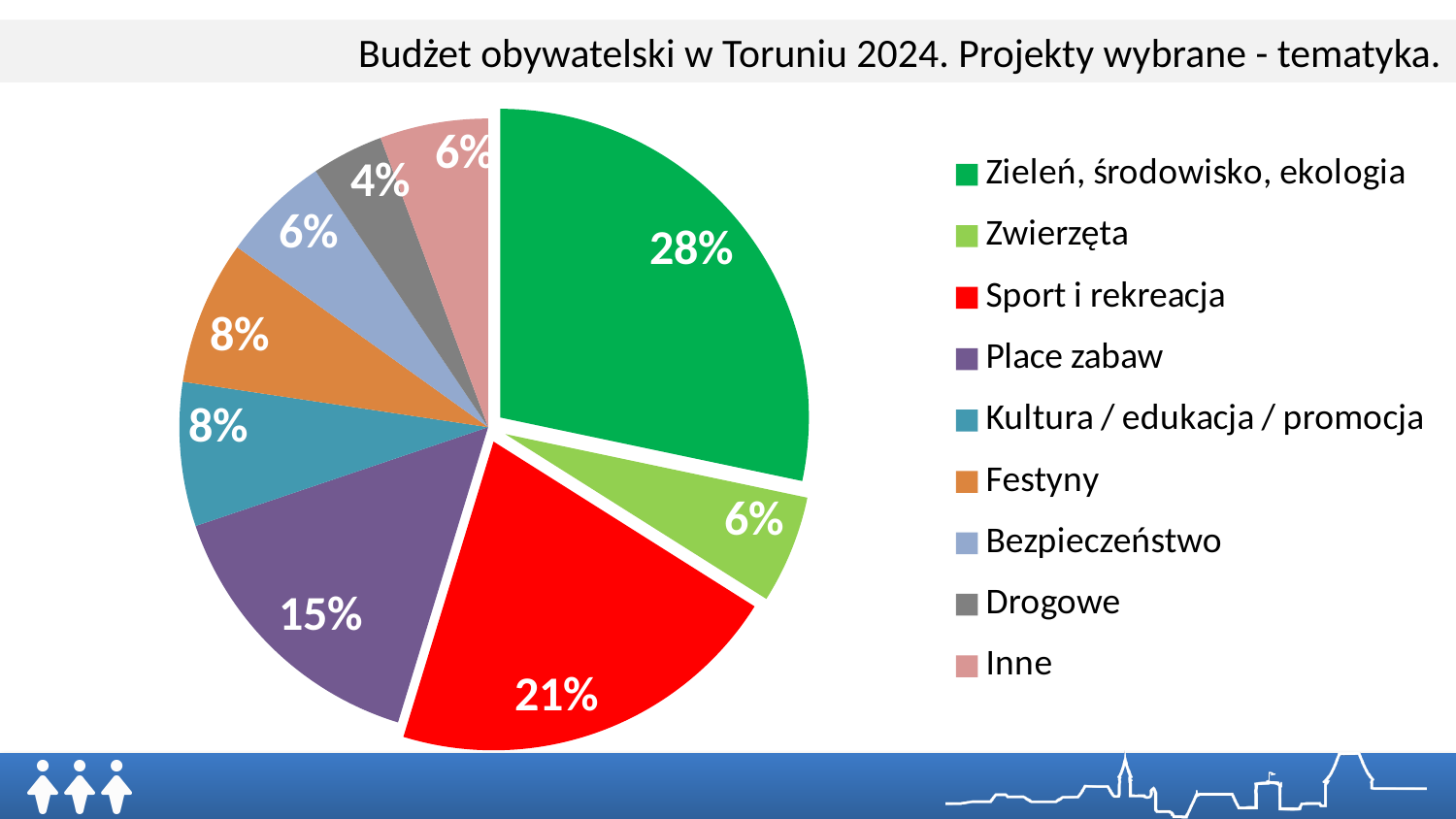
What is the title of the chart? Budżet obywatelski w Toruniu 2024. Projekty wybrane - tematyka. What is the value shown for "Festyny"? 8% How many categories does the legend list? 9 What share of the pie does "Zieleń, środowisko, ekologia" have? 28% Which is larger, the share for "Place zabaw" or the share for "Kultura / edukacja / promocja"? Place zabaw What share of the pie does "Sport i rekreacja" have? 21% Which category has the smallest slice of the pie? Drogowe Which category has the largest slice of the pie? Zieleń, środowisko, ekologia What is the value shown for "Place zabaw"? 15% What is the difference between the shares of "Zieleń, środowisko, ekologia" and "Sport i rekreacja"? 7% What is the value shown for "Drogowe"? 4% What type of chart is shown on the slide? pie chart